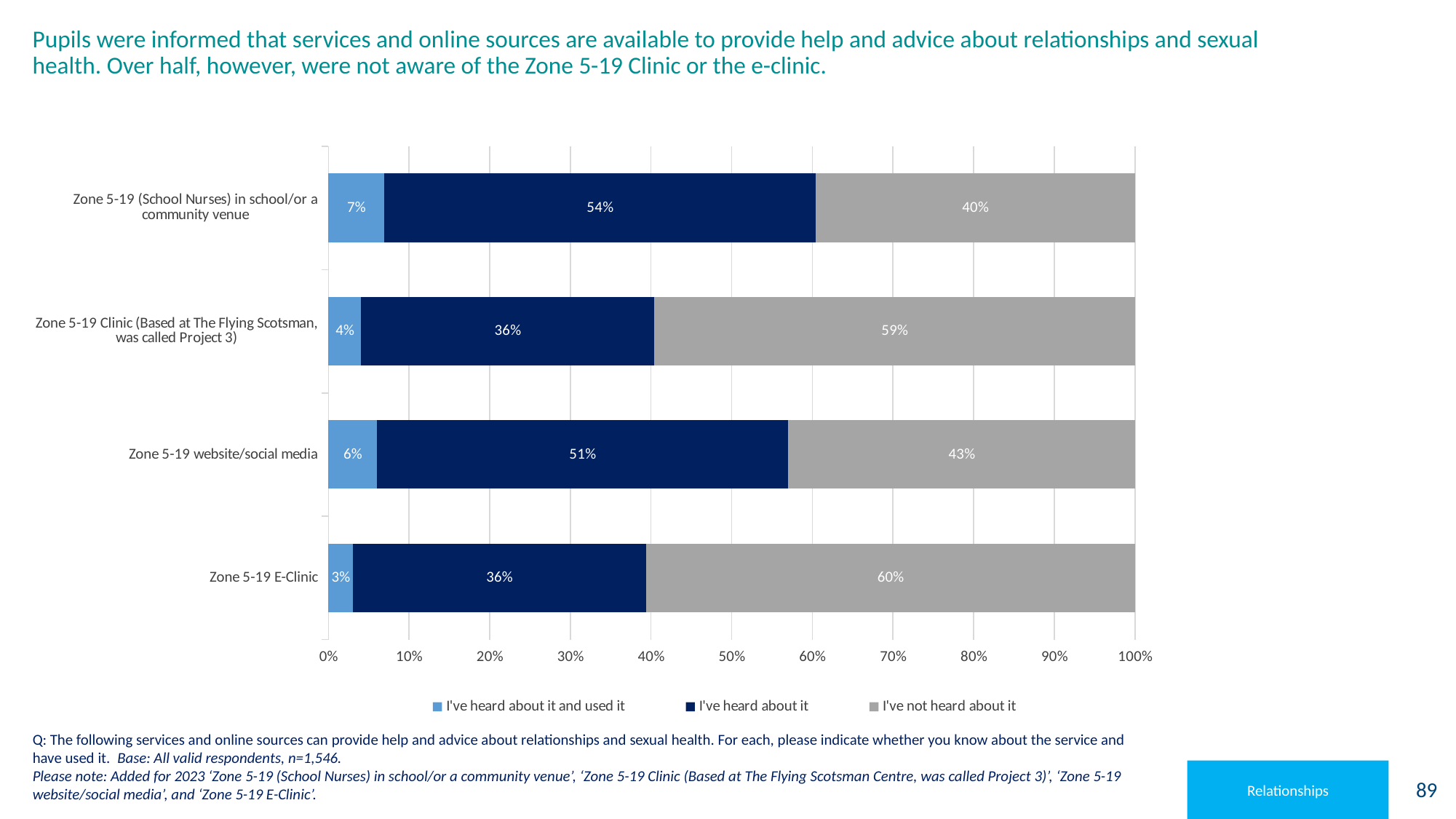
What percentage of pupils said they had heard about the Zone 5-19 website/social media? 51% What percentage of pupils said they had not heard about the Zone 5-19 E-Clinic? 60% What colour represents 'I've not heard about it' in the chart? Grey What percentage of pupils said they had not heard about the Zone 5-19 Clinic (Based at The Flying Scotsman, was called Project 3)? 59% Which service has the highest percentage of pupils who have not heard about it? Zone 5-19 E-Clinic What is the difference between the 'I've not heard about it' percentages for the Zone 5-19 E-Clinic and Zone 5-19 (School Nurses) in school/or a community venue? 20 percentage points Which service has the lowest percentage of pupils who have heard about it and used it? Zone 5-19 E-Clinic What percentage of pupils said they had heard about and used Zone 5-19 (School Nurses) in school/or a community venue? 7% What type of chart is shown on the slide? Stacked bar chart Which is larger: the 'I've heard about it' percentage for Zone 5-19 (School Nurses) or for Zone 5-19 website/social media? Zone 5-19 (School Nurses) in school/or a community venue How many series does the legend list? 3 How many services are shown on the chart? 4